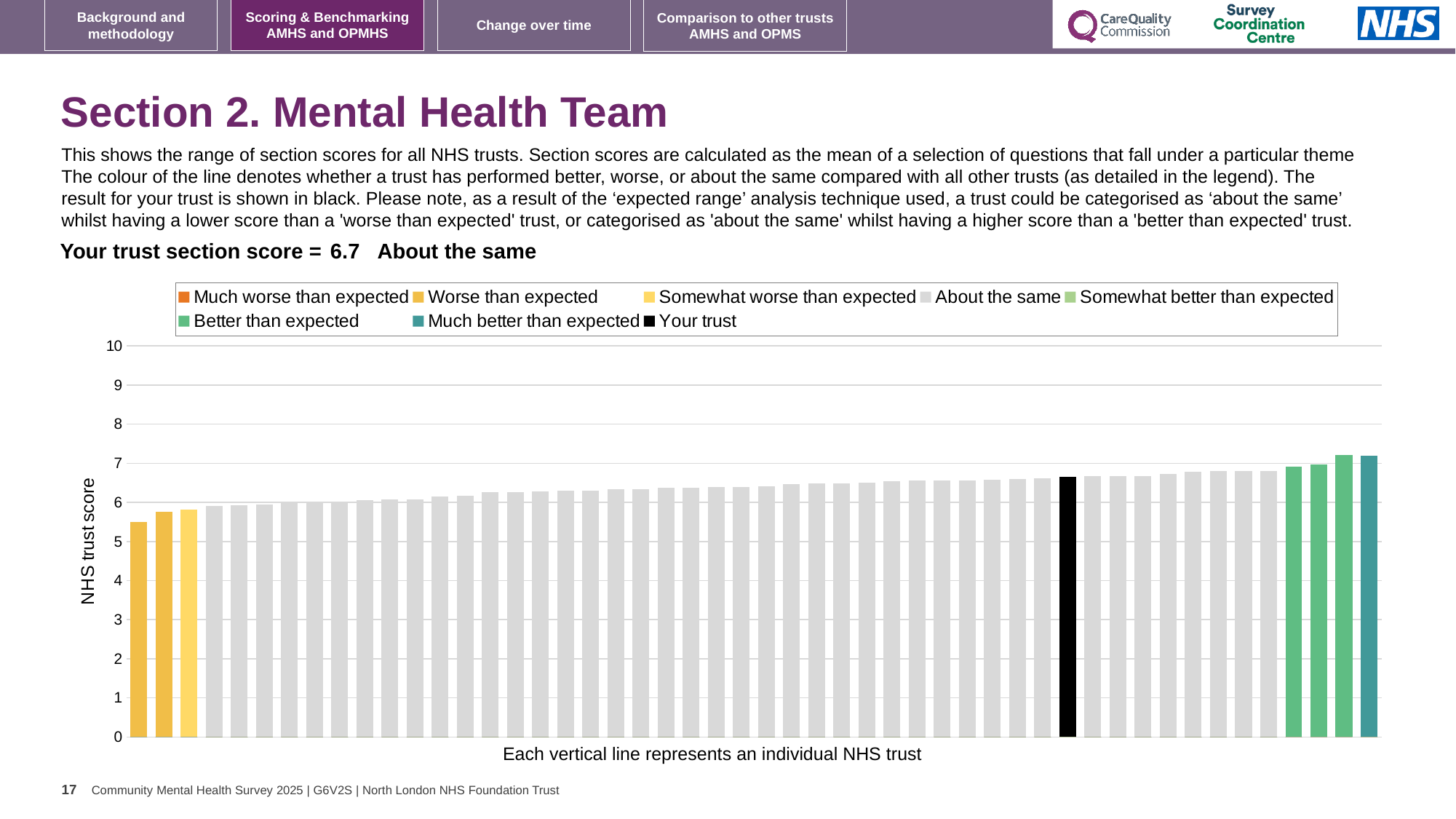
What is the highest value shown on the vertical axis of the chart? 10 How many entries does the chart legend list? 8 Is your trust's score (the black bar) greater or less than 6? greater What is the label on the vertical axis of the chart? NHS trust score Which is larger: the score of the leftmost bar or the score of the rightmost bar? the rightmost bar Is the value of the tallest bar greater or less than 7? greater What is the section score for your trust shown on the slide? 6.7 What kind of chart is shown on the slide? bar chart Is the value of the lowest bar (leftmost) greater or less than 6? less How is your trust's section score categorised compared with other trusts? About the same What colour is used in the chart to show your trust? black Do the bar values rise or fall from left to right along the x axis? rise